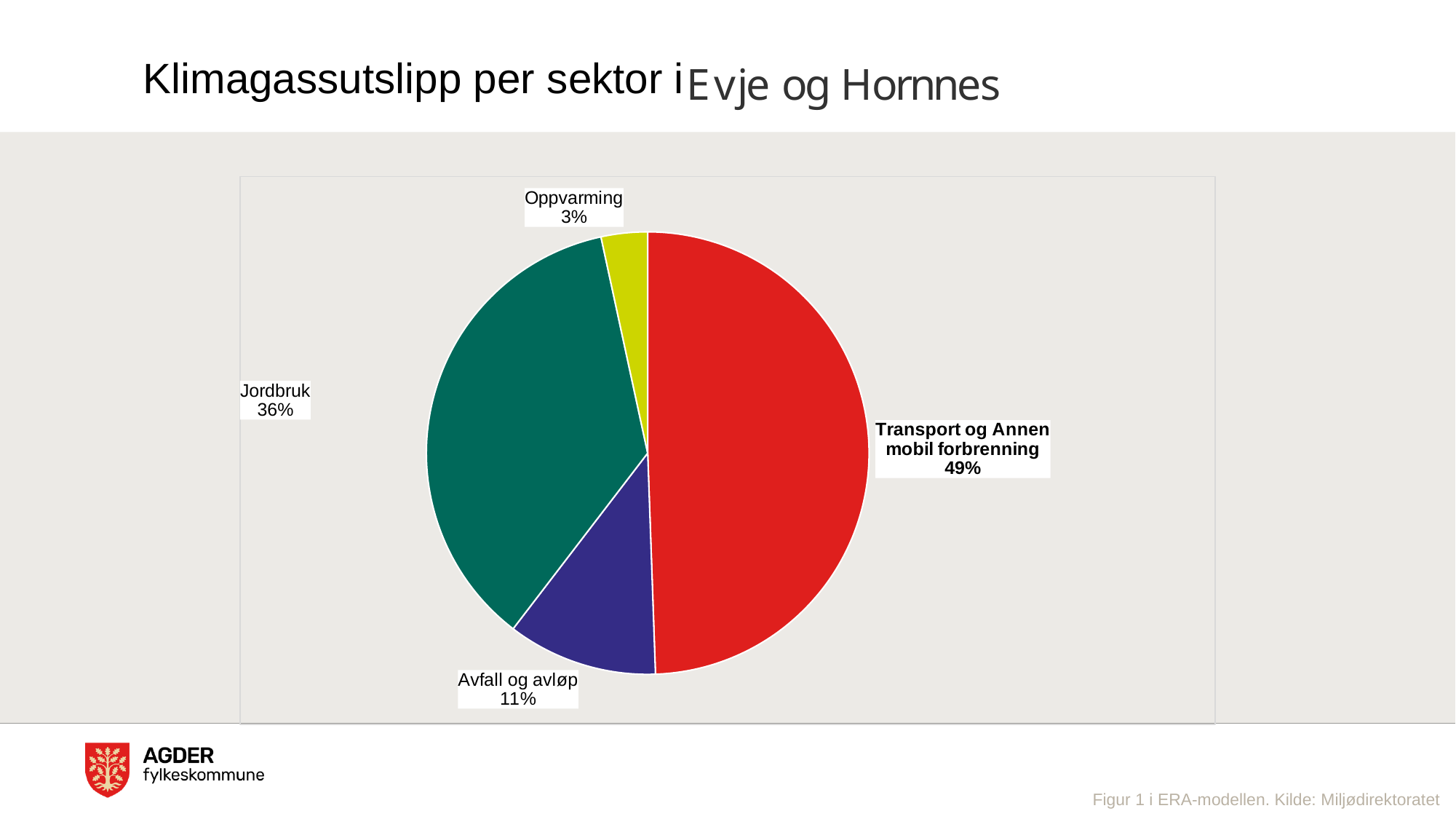
What share of emissions does Jordbruk account for? 36% How many sectors are shown in the pie chart? 4 Which sector has the smallest share of emissions? Oppvarming What is the difference in percentage points between Transport og Annen mobil forbrenning and Jordbruk? 13 What share of emissions does Transport og Annen mobil forbrenning account for? 49% What colour is the Jordbruk slice? green Which sector has the largest share of emissions? Transport og Annen mobil forbrenning What share of emissions does Oppvarming account for? 3% Which has a larger share, Jordbruk or Avfall og avløp? Jordbruk What is the difference in percentage points between Avfall og avløp and Oppvarming? 8 What kind of chart is shown on the slide? pie chart